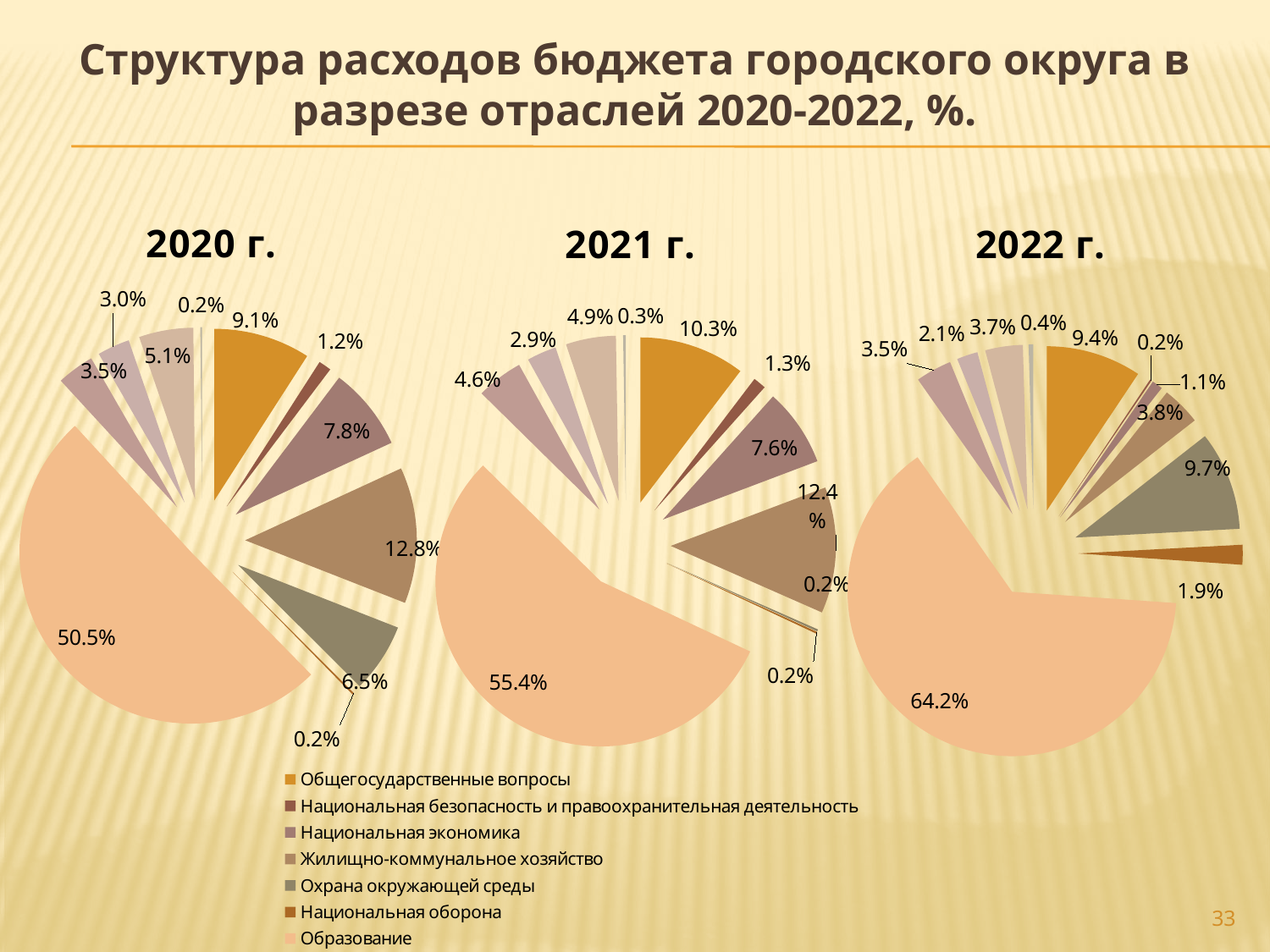
In the 2021 г. chart, what is the share for Общегосударственные вопросы? 10.3% In the 2020 г. chart, what share does the largest slice (Образование) have? 50.5% Which is larger: the Образование share in 2020 г. or in 2021 г.? 2021 г. In the 2021 г. chart, what share does Образование have? 55.4% In the 2022 г. chart, what share does Образование have? 64.2% What kind of charts are shown on the slide? Pie charts Does the share of Образование rise or fall from 2020 г. to 2022 г.? Rises In the 2022 г. chart, which category has the largest slice? Образование By how many percentage points is the Образование share in 2022 г. larger than in 2021 г.? 8.8 How many pie charts are on the slide? 3 In the 2020 г. chart, what is the share for Общегосударственные вопросы? 9.1%